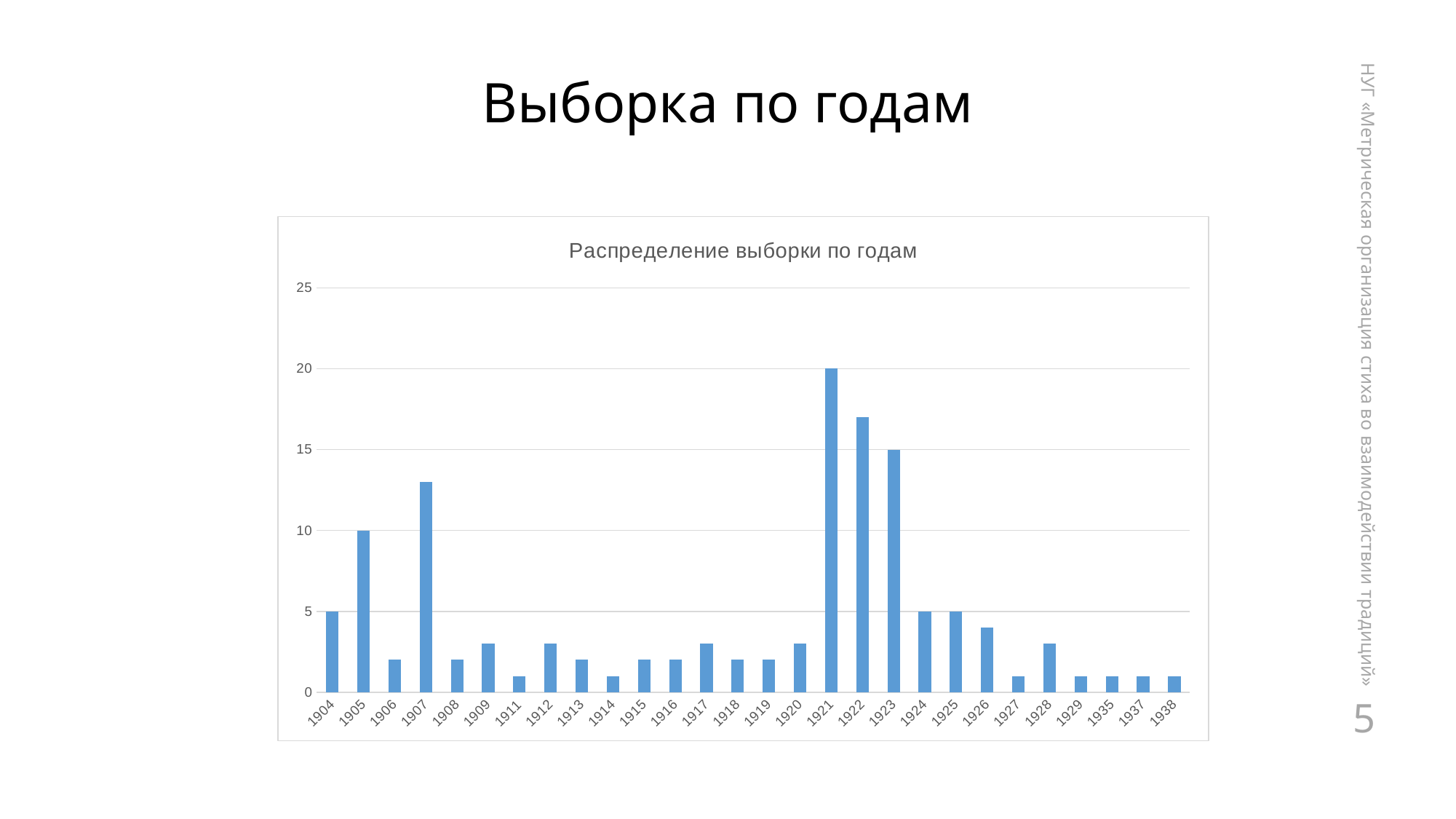
Is the value for 1926 greater or less than 5? less What is the title of the chart? Распределение выборки по годам Is the value for 1907 greater or less than 10? greater What is the value for 1904? 5 How many years (categories) are shown on the x axis of the chart? 28 What is the difference between the values for 1921 and 1923? 5 What is the value for 1921? 20 Which is larger, the value for 1907 or the value for 1922? 1922 Which year has the highest value in the chart? 1921 What is the value for 1923? 15 What type of chart is shown on the slide? bar chart What is the value for 1905? 10